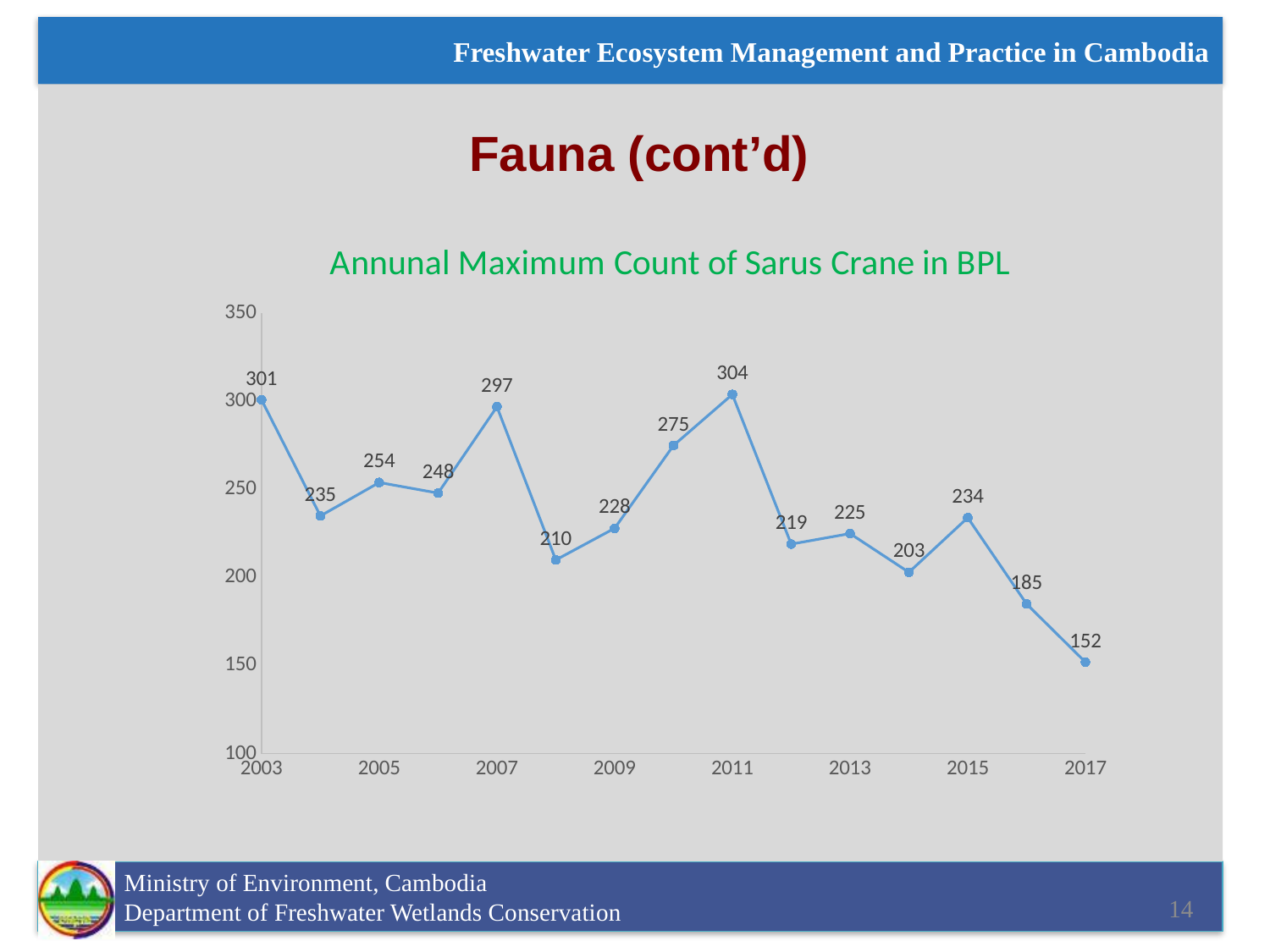
Overall, does the annual maximum count of Sarus Crane rise or fall from 2003 to 2017? fall What is the annual maximum count of Sarus Crane in 2017? 152 What is the title of the chart? Annunal Maximum Count of Sarus Crane in BPL What is the difference between the count in 2011 and the count in 2017? 152 How many data points are plotted on the line? 15 Which year has the highest annual maximum count of Sarus Crane? 2011 Which year has a larger count, 2009 or 2013? 2009 What is the annual maximum count of Sarus Crane in 2011? 304 What is the annual maximum count of Sarus Crane in 2007? 297 What is the annual maximum count of Sarus Crane in 2003? 301 What kind of chart is shown on the slide? line chart Which year has the lowest annual maximum count of Sarus Crane? 2017